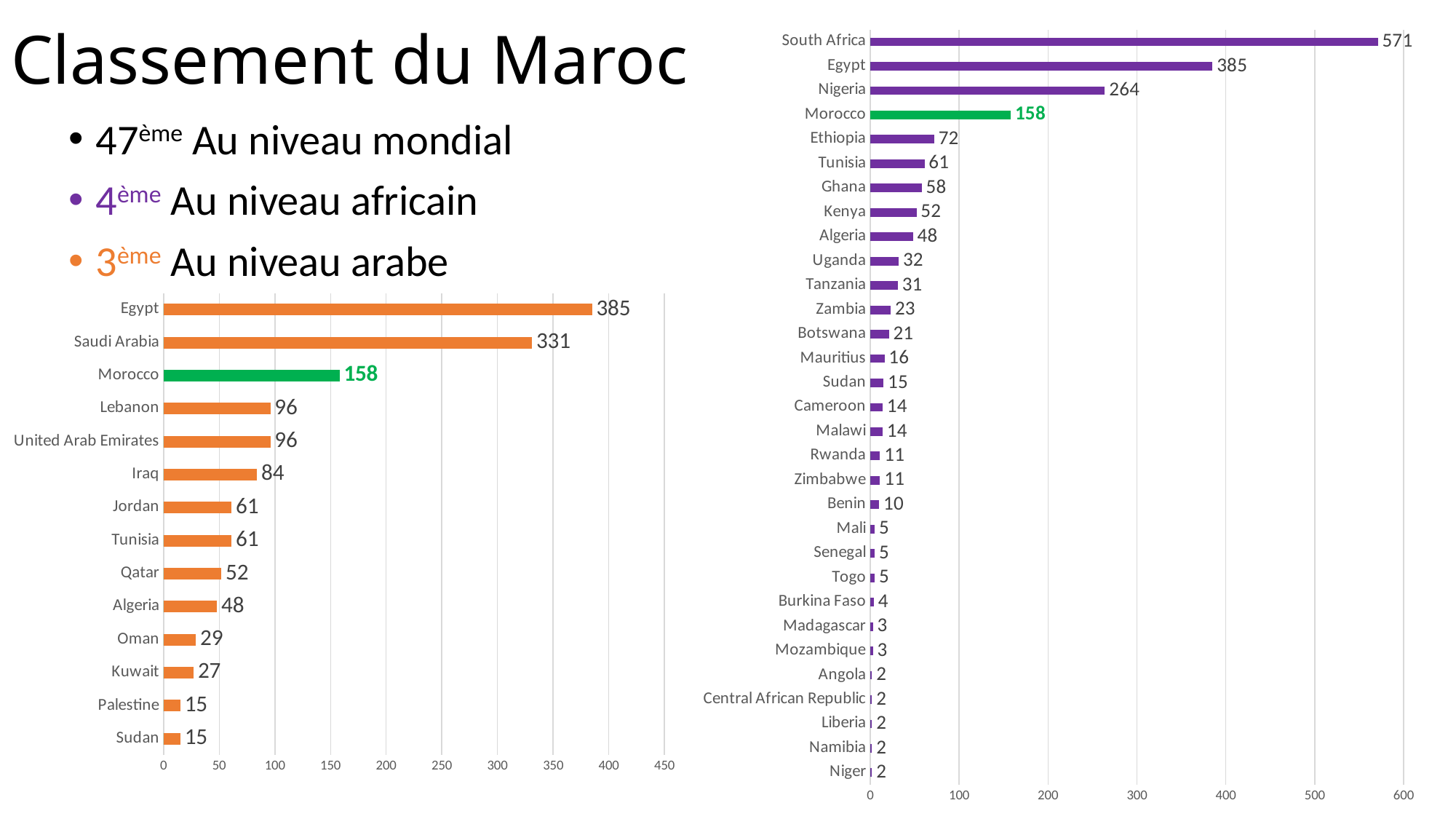
In the chart on the right of the slide, is the value for Ethiopia greater or less than 100? less What type of chart is the chart on the right of the slide? Bar chart In the chart on the left of the slide, what colour is the bar for Morocco? Green In the chart on the left of the slide, which country has the highest value? Egypt How many countries are shown in the chart on the right of the slide? 31 In the chart on the right of the slide, what is the value for Nigeria? 264 In the chart on the right of the slide, what is the difference between the values for South Africa and Egypt? 186 In the chart on the right of the slide, which country has the highest value? South Africa In the chart on the left of the slide, what is the value for Saudi Arabia? 331 In the chart on the left of the slide, what is the difference between the values for Egypt and Morocco? 227 In the chart on the left of the slide, which is larger, the value for Iraq or the value for Jordan? Iraq How many countries are shown in the chart on the left of the slide? 14